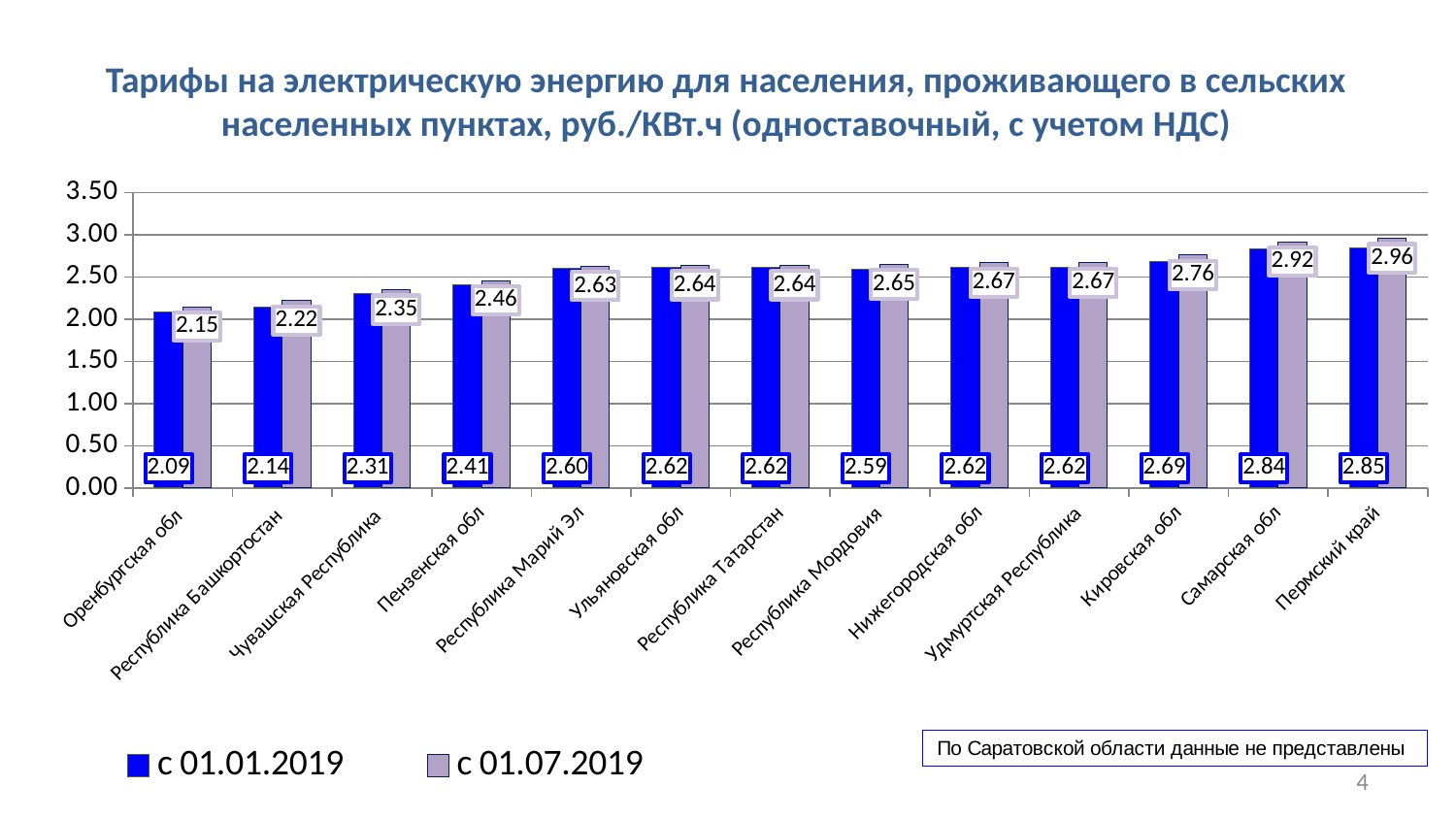
How many series does the legend list? 2 Which region has the lowest value in the с 01.01.2019 series? Оренбургская обл Which region has the highest value in the с 01.07.2019 series? Пермский край What is the value for Пензенская обл in the с 01.01.2019 series? 2.41 What is the value for Кировская обл in the с 01.07.2019 series? 2.76 Which is larger: the с 01.01.2019 value for Чувашская Республика or for Республика Башкортостан? Чувашская Республика What kind of chart is shown on the slide? bar chart What is the difference between the с 01.07.2019 and с 01.01.2019 values for Пермский край? 0.11 What is the value for Республика Мордовия in the с 01.01.2019 series? 2.59 What is the difference between the с 01.07.2019 values for Самарская обл and Оренбургская обл? 0.77 How many regions are shown on the x axis of the chart? 13 Do the с 01.07.2019 values generally rise or fall from left to right along the x axis? rise